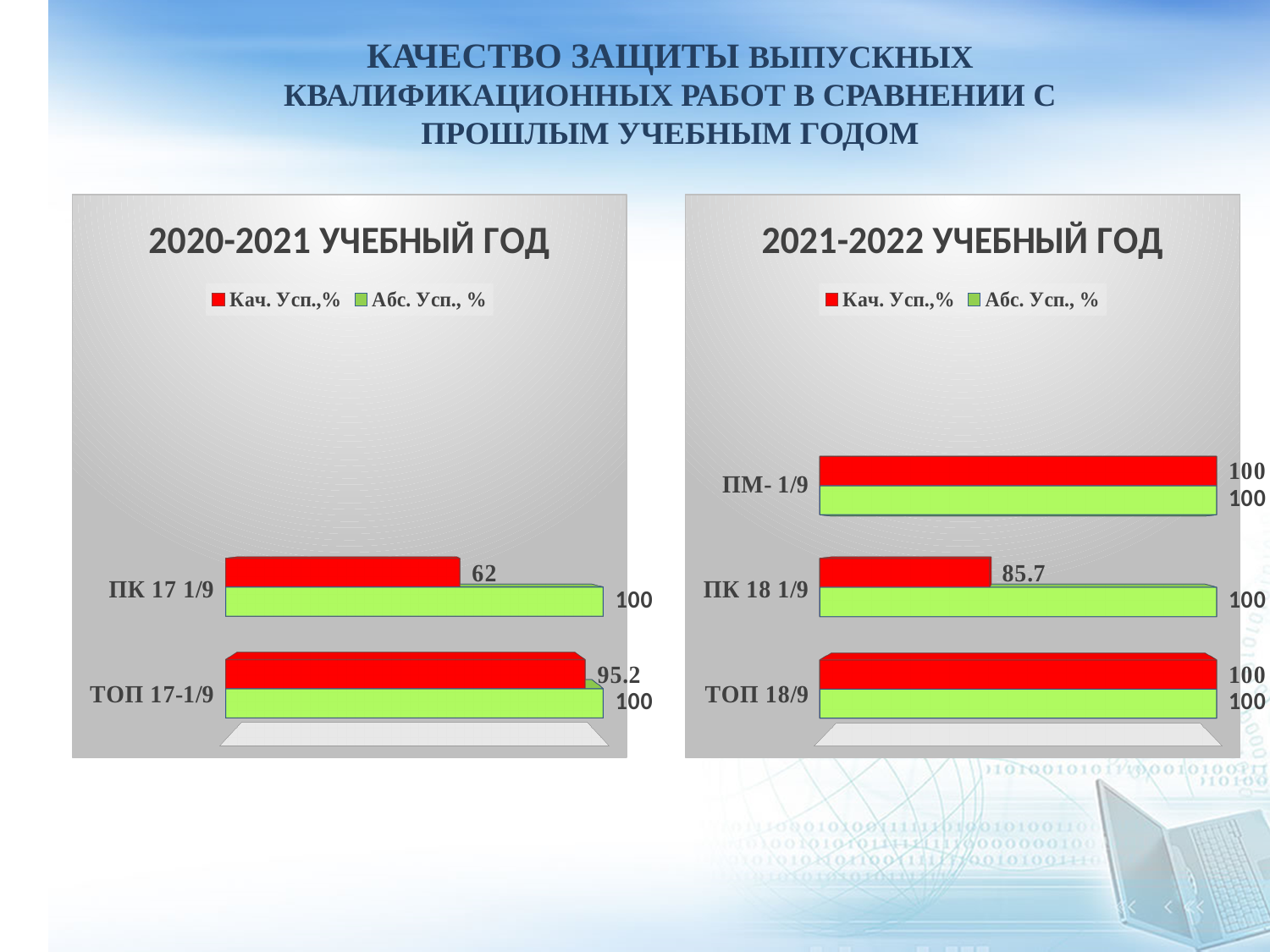
In the "2021-2022 УЧЕБНЫЙ ГОД" chart, what is the difference between the Абс. Усп., % and Кач. Усп.,% values for ПК 18 1/9? 14.3 In the "2020-2021 УЧЕБНЫЙ ГОД" chart, which is larger: the Кач. Усп.,% value for ТОП 17-1/9 or for ПК 17 1/9? ТОП 17-1/9 In the "2021-2022 УЧЕБНЫЙ ГОД" chart, what is the Кач. Усп.,% value for ПК 18 1/9? 85.7 In the "2020-2021 УЧЕБНЫЙ ГОД" chart, what is the Кач. Усп.,% value for ТОП 17-1/9? 95.2 How many categories are shown in the "2021-2022 УЧЕБНЫЙ ГОД" chart? 3 In the "2021-2022 УЧЕБНЫЙ ГОД" chart, what is the Кач. Усп.,% value for ПМ- 1/9? 100 In the "2021-2022 УЧЕБНЫЙ ГОД" chart, which category has the lowest Кач. Усп.,% value? ПК 18 1/9 How many series does the legend of the "2020-2021 УЧЕБНЫЙ ГОД" chart list? 2 In the "2020-2021 УЧЕБНЫЙ ГОД" chart, what is the difference between the Абс. Усп., % and Кач. Усп.,% values for ПК 17 1/9? 38 In the "2020-2021 УЧЕБНЫЙ ГОД" chart, what is the Абс. Усп., % value for ПК 17 1/9? 100 In the "2020-2021 УЧЕБНЫЙ ГОД" chart, what is the Кач. Усп.,% value for ПК 17 1/9? 62 In the "2020-2021 УЧЕБНЫЙ ГОД" chart, which category has the lowest Кач. Усп.,% value? ПК 17 1/9